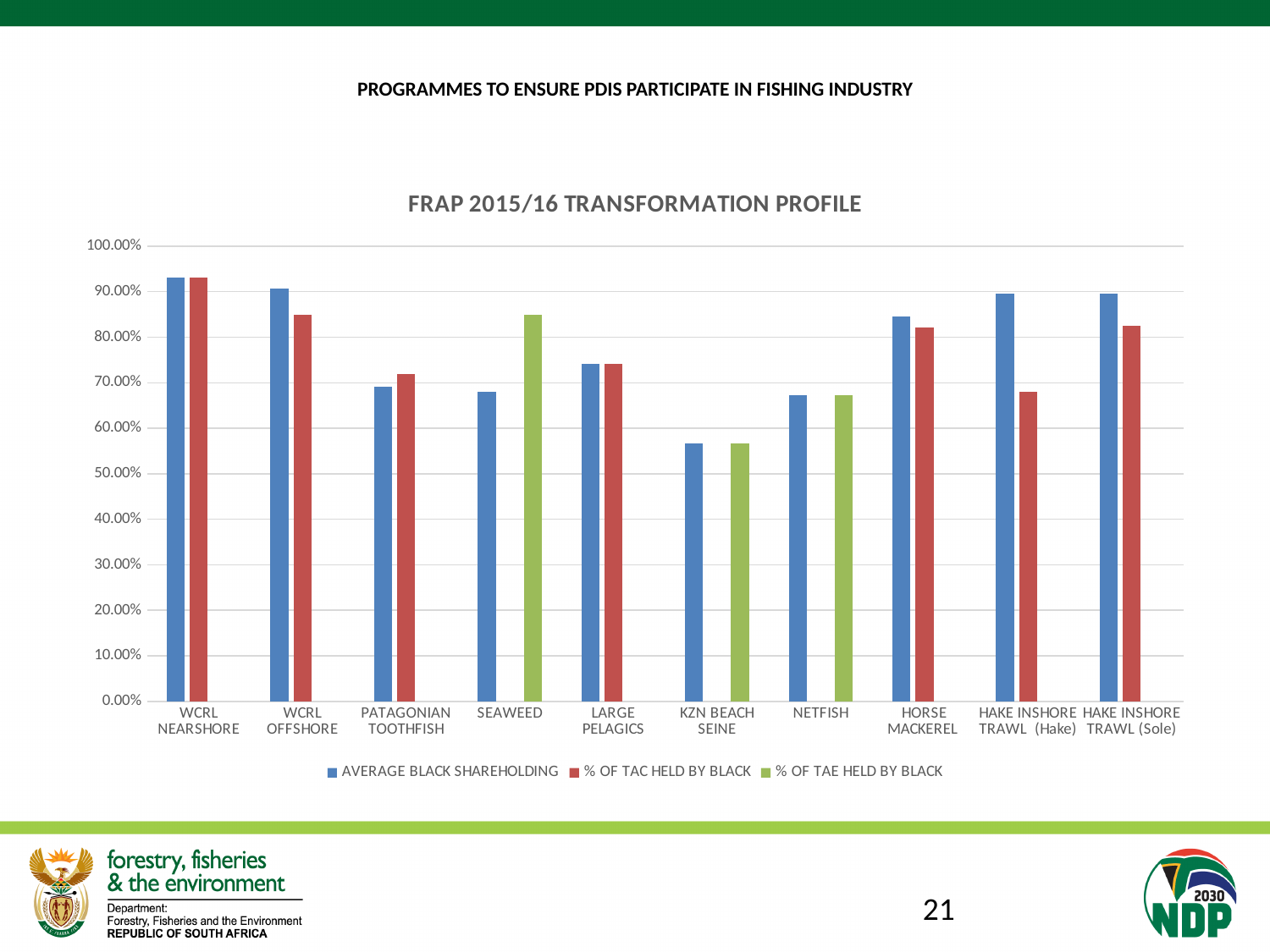
Which category has the lowest AVERAGE BLACK SHAREHOLDING? KZN BEACH SEINE For WCRL OFFSHORE, which is larger: AVERAGE BLACK SHAREHOLDING or % OF TAC HELD BY BLACK? AVERAGE BLACK SHAREHOLDING Is the % OF TAE HELD BY BLACK for SEAWEED greater or less than 80.00%? greater What type of chart is shown on the slide? Bar chart How many fishery categories are shown on the x axis? 10 How many categories have a % OF TAE HELD BY BLACK bar? 3 Which category has the highest AVERAGE BLACK SHAREHOLDING? WCRL NEARSHORE Is the AVERAGE BLACK SHAREHOLDING for KZN BEACH SEINE greater or less than 60.00%? less How many series does the legend list? 3 Is the AVERAGE BLACK SHAREHOLDING for WCRL NEARSHORE greater or less than 90.00%? greater What is the title of the chart? FRAP 2015/16 TRANSFORMATION PROFILE